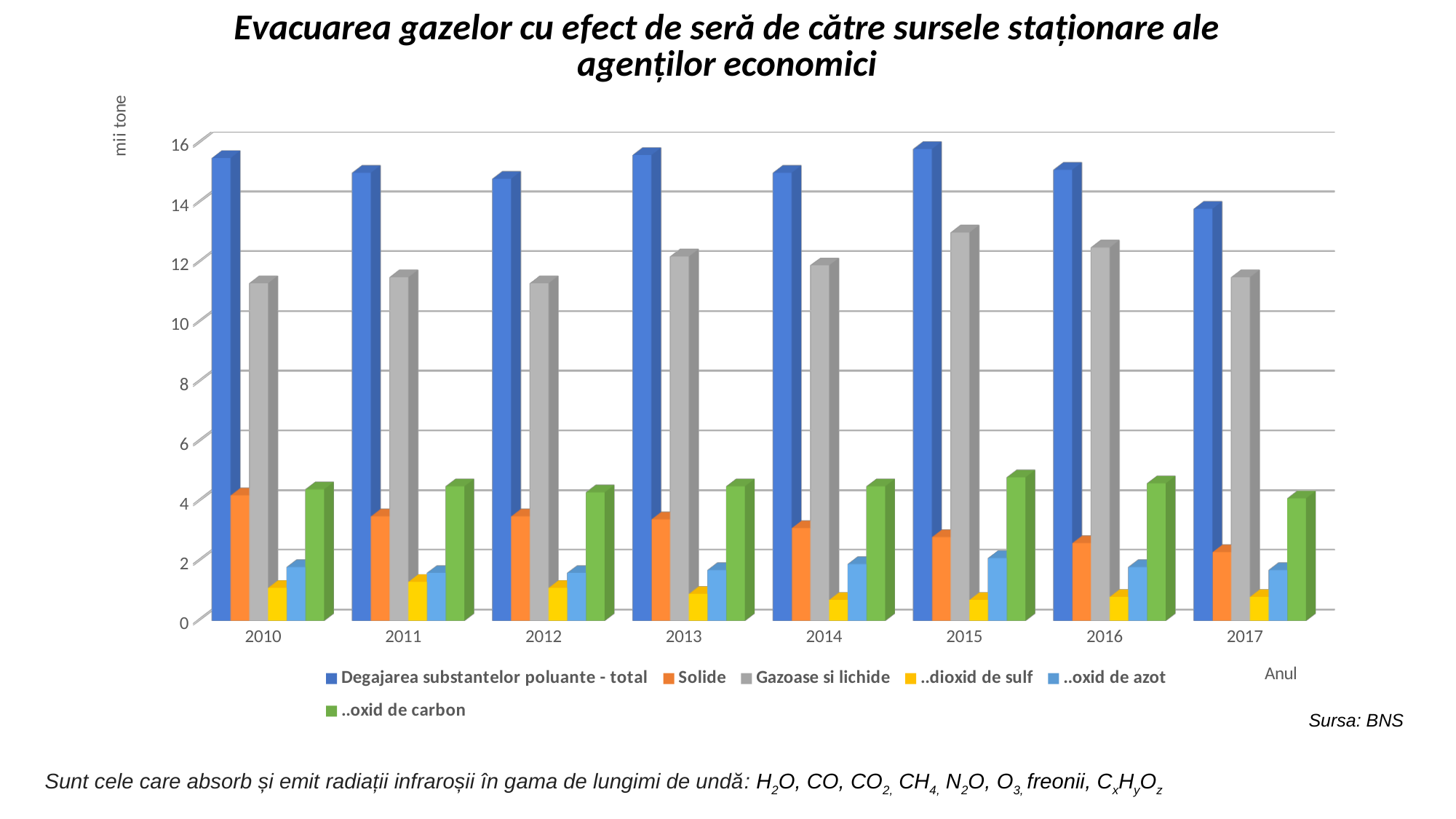
How many series does the chart legend list? 6 Is the value for 'Degajarea substantelor poluante - total' in 2017 greater or less than 14? less Does the value for 'Solide' rise or fall from 2010 to 2017? fall What kind of chart is shown on the slide? bar chart In which year is the value for 'Solide' the highest? 2010 Which is larger in 2016: the value for 'Solide' or the value for '..oxid de carbon'? ..oxid de carbon How many years are shown on the x axis of the chart? 8 In which year is the value for 'Degajarea substantelor poluante - total' the lowest? 2017 Is the value for 'Gazoase si lichide' in 2015 greater or less than 12? greater What unit is shown on the vertical axis of the chart? mii tone In which year is the value for 'Gazoase si lichide' the highest? 2015